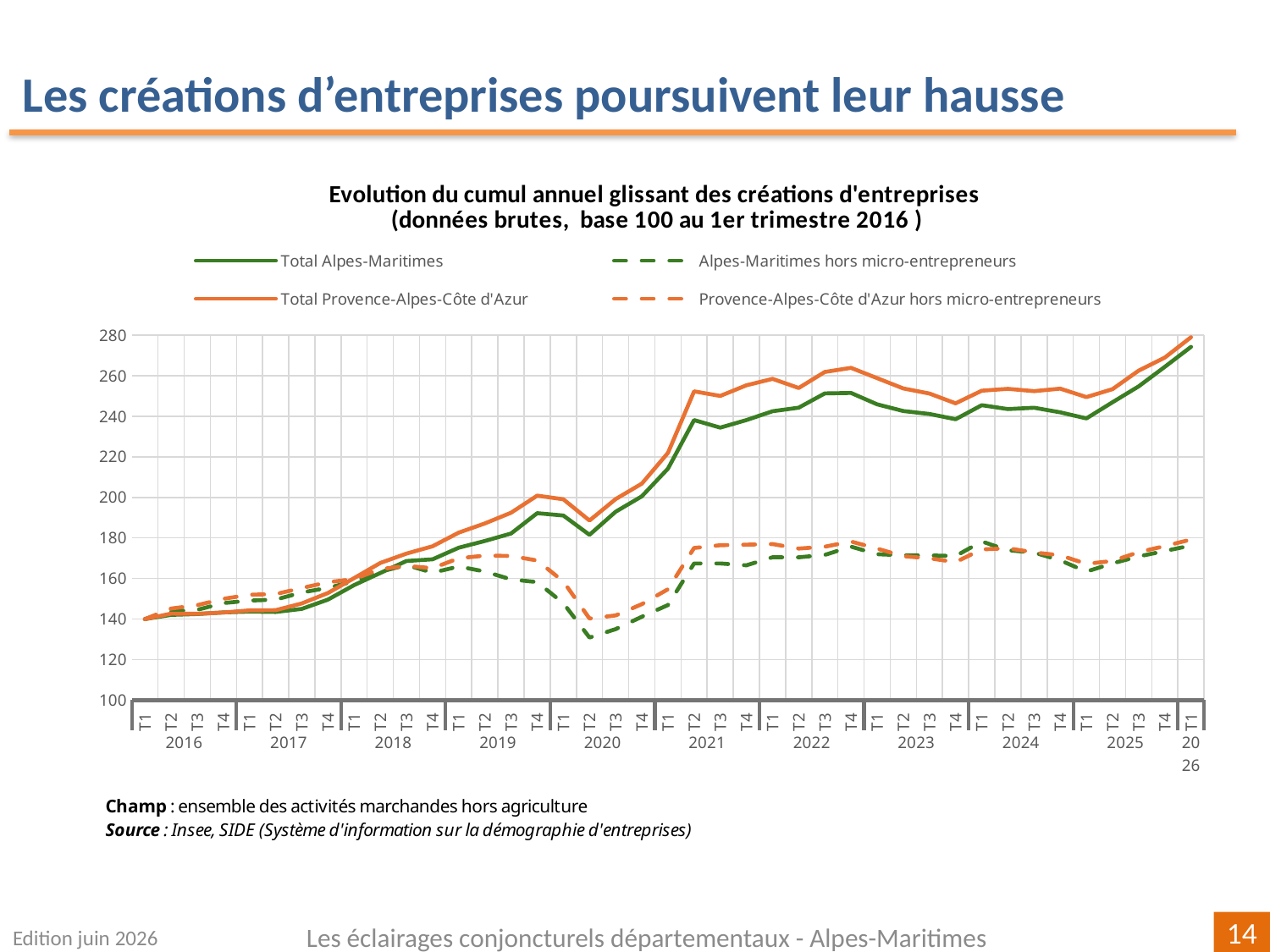
Is the value for Alpes-Maritimes hors micro-entrepreneurs at T2 2020 greater or less than 140? less Which line style is used for the 'hors micro-entrepreneurs' series in the legend? dashed How many year labels appear along the x axis? 11 Does the Total Alpes-Maritimes series rise or fall overall from T1 2016 to T1 2026? rise In which quarter does the Alpes-Maritimes hors micro-entrepreneurs series reach its lowest point? T2 2020 Which series reaches the highest value on the chart? Total Provence-Alpes-Côte d'Azur At T4 2022, which is higher: Total Provence-Alpes-Côte d'Azur or Total Alpes-Maritimes? Total Provence-Alpes-Côte d'Azur Is the value for Total Provence-Alpes-Côte d'Azur at T1 2026 greater or less than 260? greater Does the Total Alpes-Maritimes series rise or fall between T4 2019 and T2 2020? fall Is the value for Total Alpes-Maritimes at T2 2021 greater or less than 220? greater What kind of chart is shown on the slide? line chart How many series does the legend list? 4